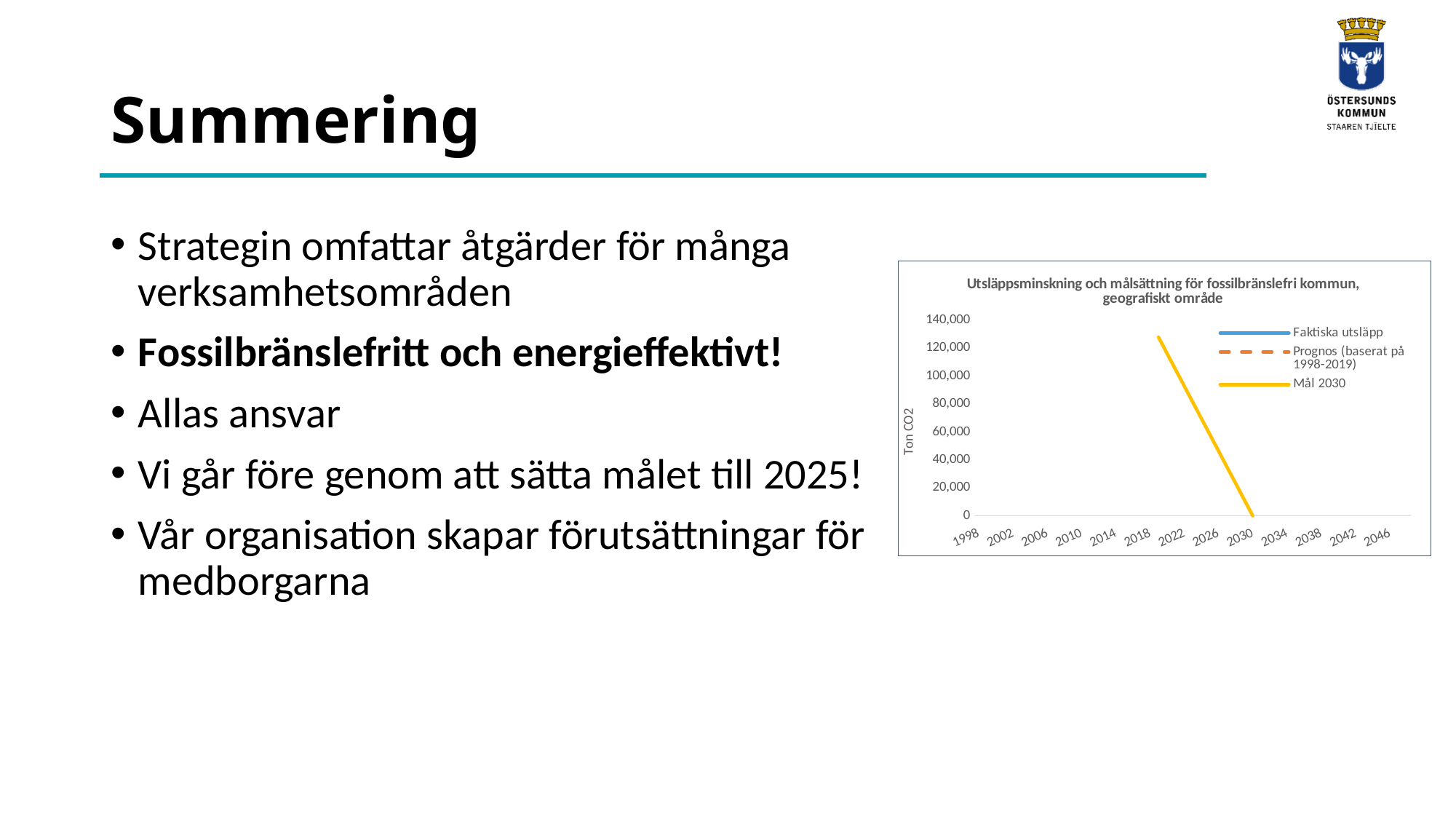
Is the value of the Mål 2030 line in 2026 greater or less than 60,000? less Is the value of the Mål 2030 line in 2022 greater or less than 60,000? greater How many series does the chart's legend list? 3 What is the title of the chart? Utsläppsminskning och målsättning för fossilbränslefri kommun, geografiskt område How many year labels are shown on the x axis of the chart? 13 What is the label of the vertical axis of the chart? Ton CO2 Which series in the legend is drawn with a dashed line? Prognos (baserat på 1998-2019) Is the starting value of the Mål 2030 line greater or less than 100,000? greater What value does the Mål 2030 line reach in 2030? 0 What is the highest value shown on the vertical axis of the chart? 140,000 What kind of chart is shown on the slide? line chart Does the Mål 2030 line rise or fall along the x axis? fall